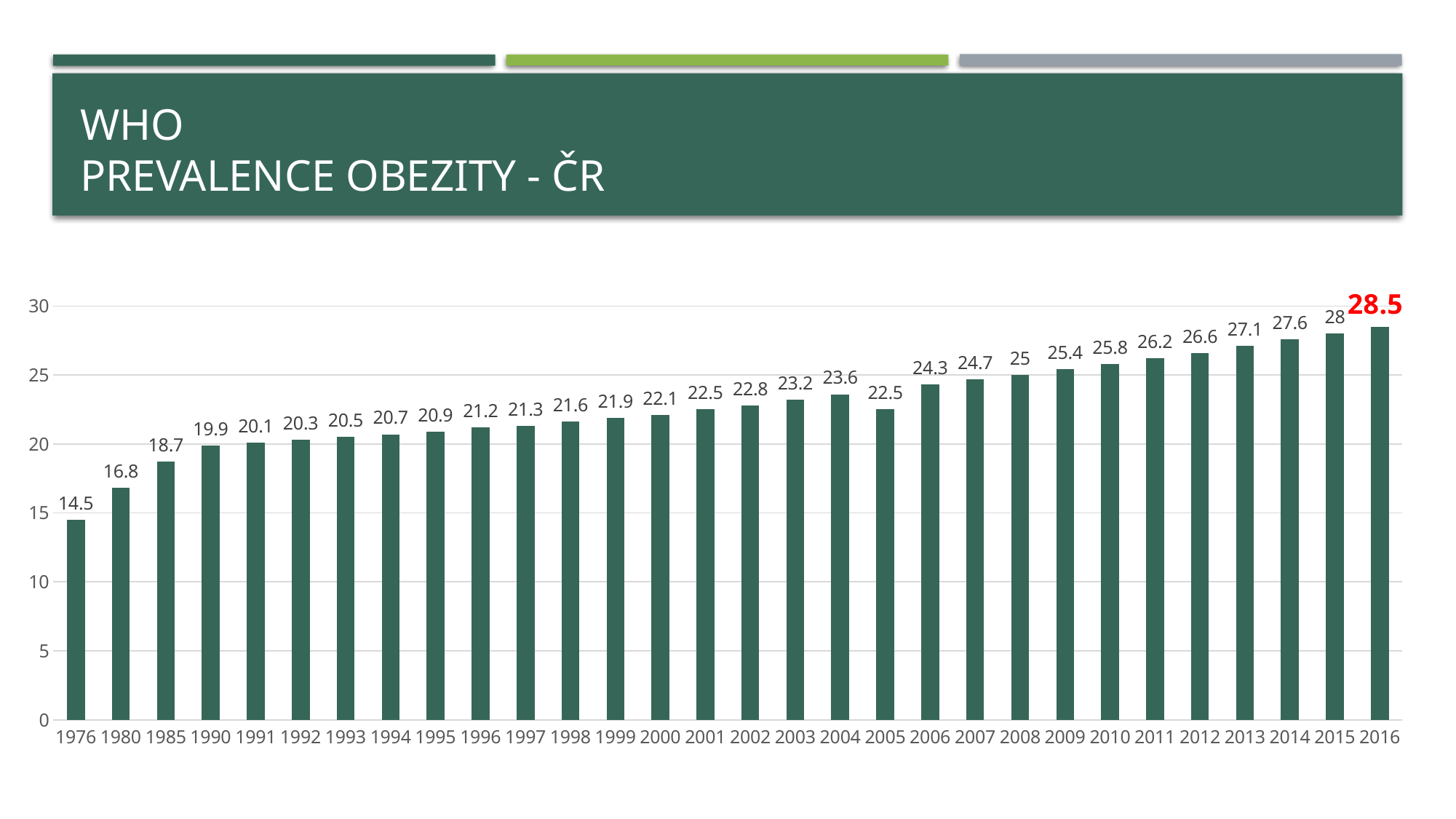
What is the value for 2016? 28.5 Do the values generally rise or fall from 1976 to 2016? Rise What is the value for 2005? 22.5 What is the difference between the values for 2016 and 1976? 14 Which year has the highest value? 2016 Which year has the lowest value? 1976 What kind of chart is shown on the slide? Bar chart Which is larger, the value for 2004 or the value for 2005? 2004 How many bars are shown in the chart? 30 What is the difference between the values for 2004 and 2005? 1.1 What is the value for 2008? 25 What is the value for 1976? 14.5